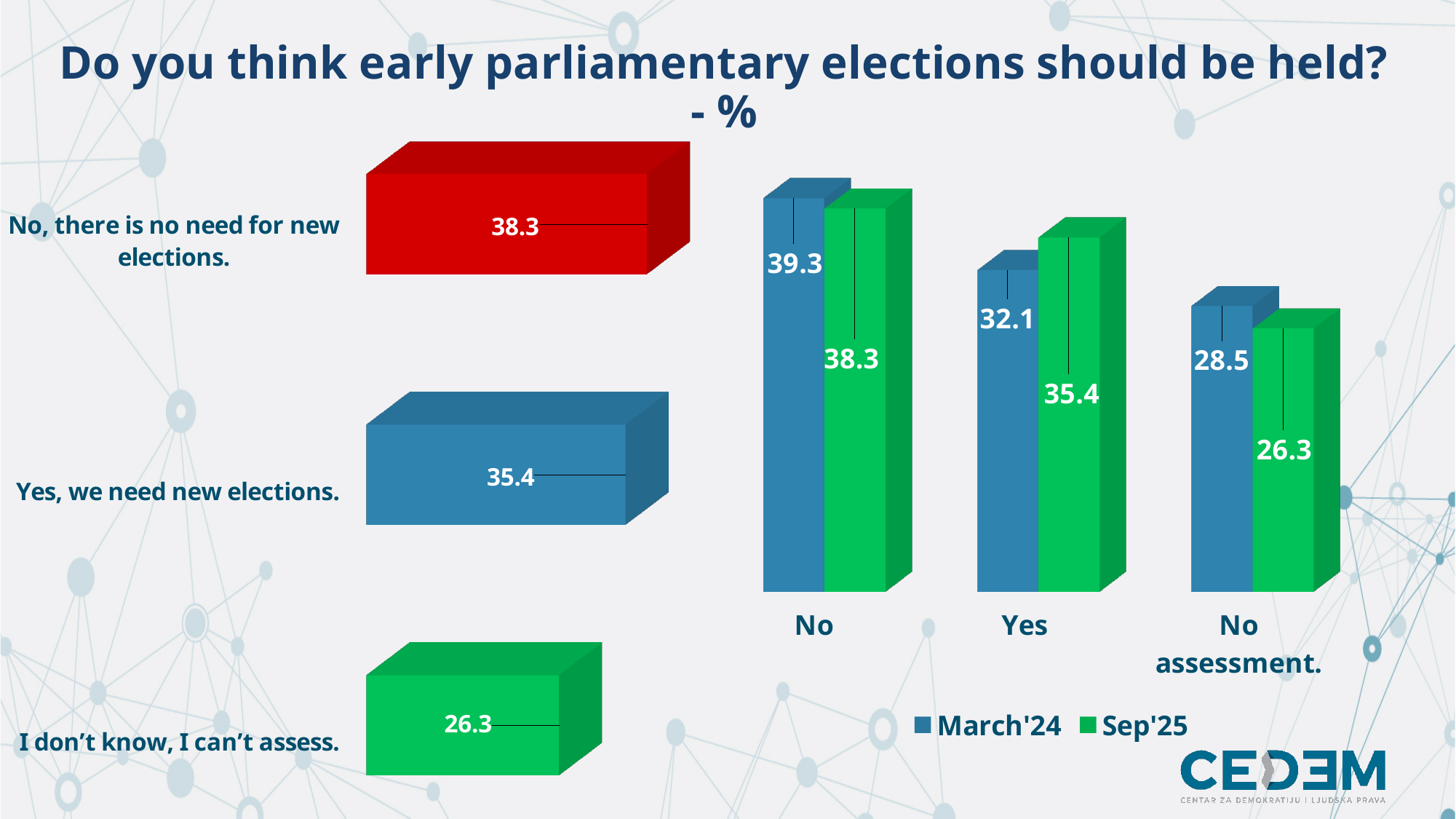
In the right chart, how many series does the legend list? 2 In the right chart, which is larger for "No assessment.": March'24 or Sep'25? March'24 In the left chart, which category has the lowest value? I don't know, I can't assess. In the right chart, which category has the highest March'24 value? No In the left chart, what is the value for "Yes, we need new elections."? 35.4 In the right chart, what is the March'24 value for "No"? 39.3 In the right chart, what is the Sep'25 value for "Yes"? 35.4 In the left chart, what is the value for "No, there is no need for new elections."? 38.3 In the right chart, what is the difference between the March'24 and Sep'25 values for "Yes"? 3.3 What kind of chart is the left chart? bar chart In the left chart, how many categories are shown? 3 In the left chart, what is the difference between "No, there is no need for new elections." and "I don't know, I can't assess."? 12